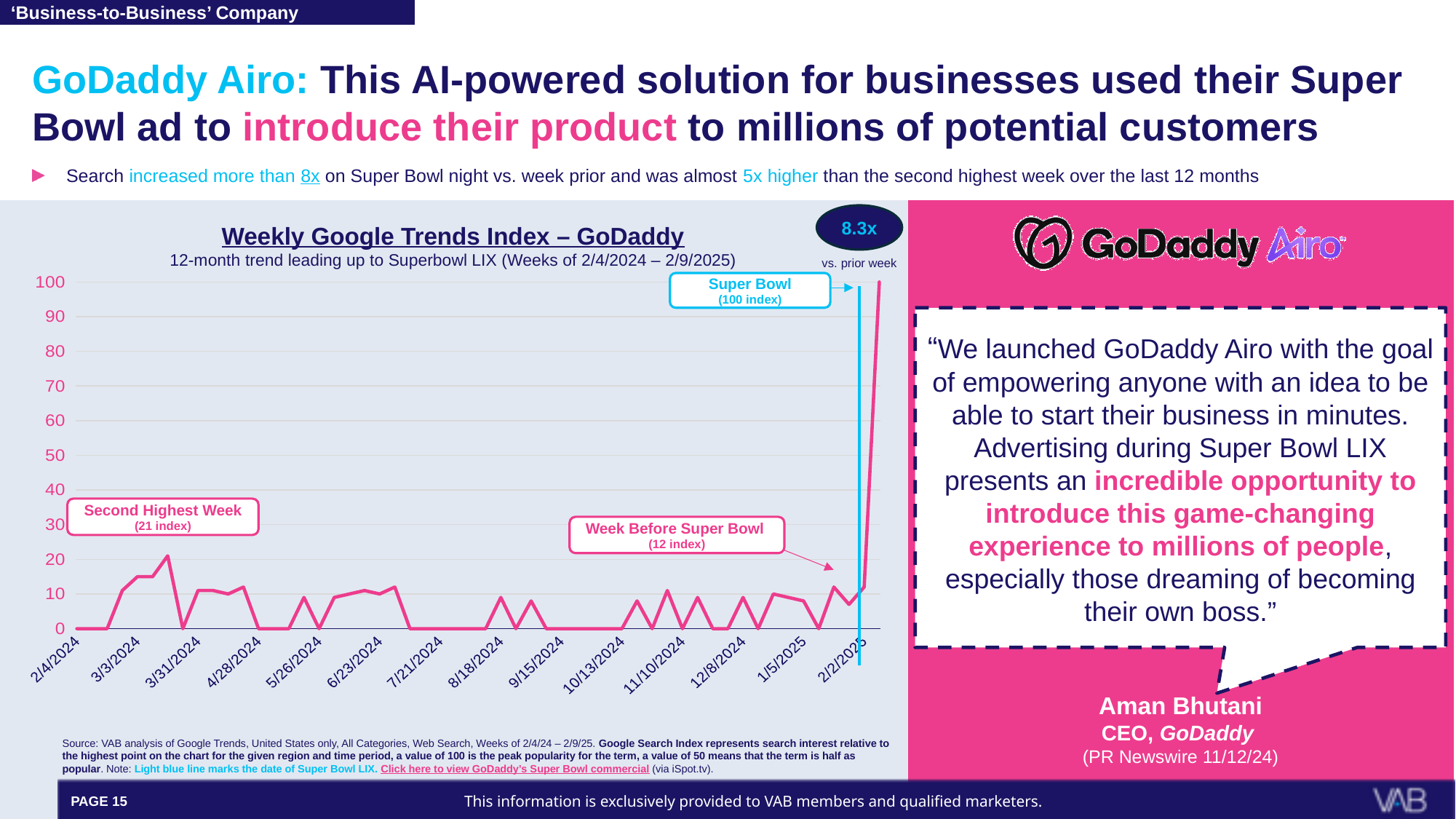
Which week has the highest index value on the chart? Super Bowl week What is the difference between the Super Bowl week index and the Week Before Super Bowl index? 88 What index value is labeled for the Second Highest Week? 21 What is the difference between the Super Bowl week index and the Second Highest Week index? 79 How many date labels are shown on the x axis? 14 What kind of chart is shown on the slide? line chart What index value is labeled for the Week Before Super Bowl? 12 Is the value for 2/4/2024 greater or less than 10? less What index value does the chart show for the Super Bowl week? 100 Which is larger, the Second Highest Week index or the Week Before Super Bowl index? Second Highest Week What is the title of the chart? Weekly Google Trends Index – GoDaddy According to the callout, how many times higher was the Super Bowl week index vs. the prior week? 8.3x